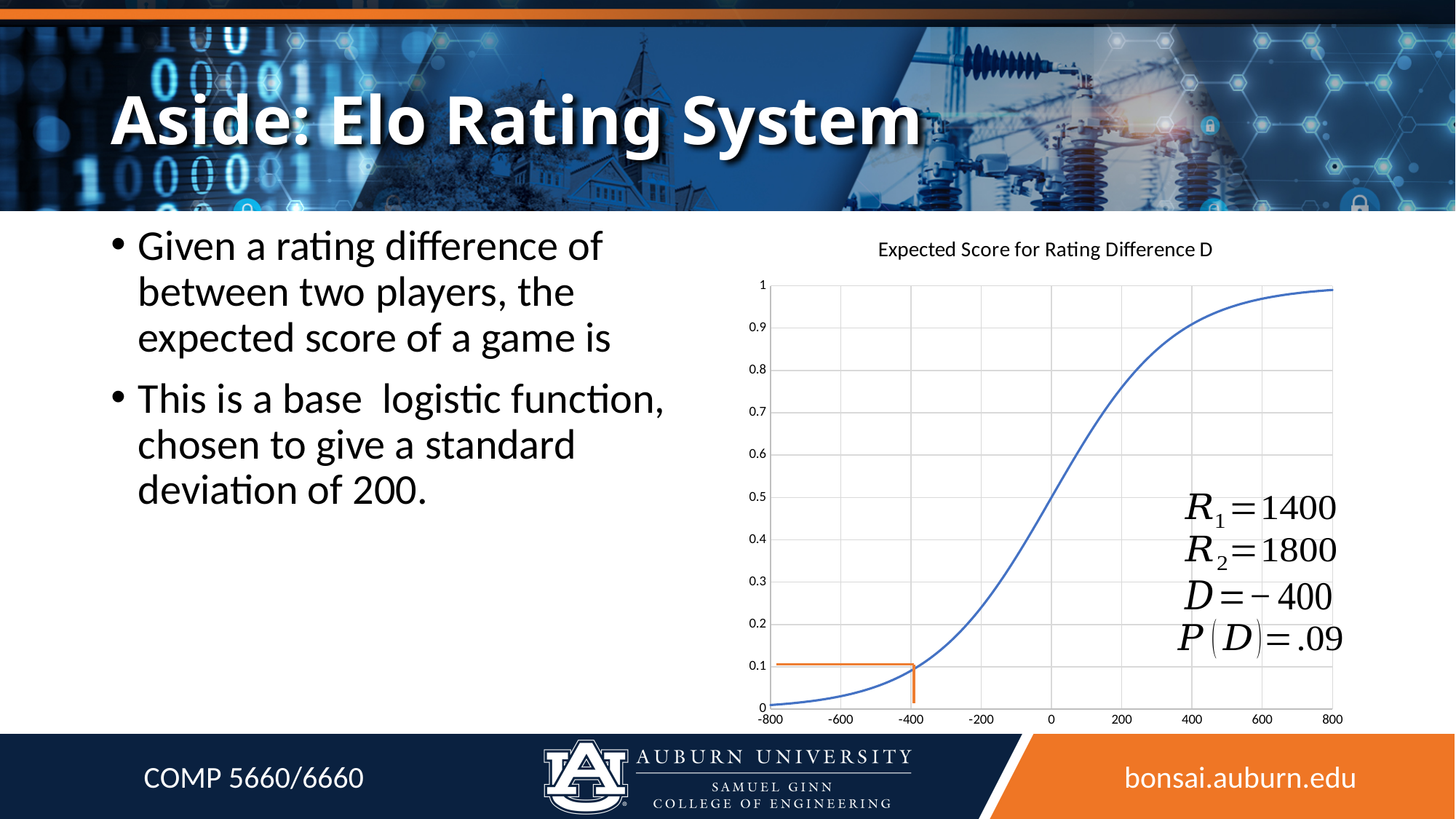
According to the annotation on the chart, what is P(D) when D = -400? .09 What is the title of the chart? Expected Score for Rating Difference D According to the annotation on the chart, what is the value of R1? 1400 According to the annotation on the chart, what is the value of R2? 1800 What kind of chart is shown on the slide? line chart Is the expected score at D = 800 greater or less than 0.9? greater Which has the larger expected score, D = 200 or D = -200? D = 200 How many tick labels are shown on the x axis of the chart? 9 Is the expected score at D = -800 greater or less than 0.1? less Is the expected score at D = -400 greater or less than 0.2? less Does the expected score rise or fall as the rating difference D increases along the x axis? rise